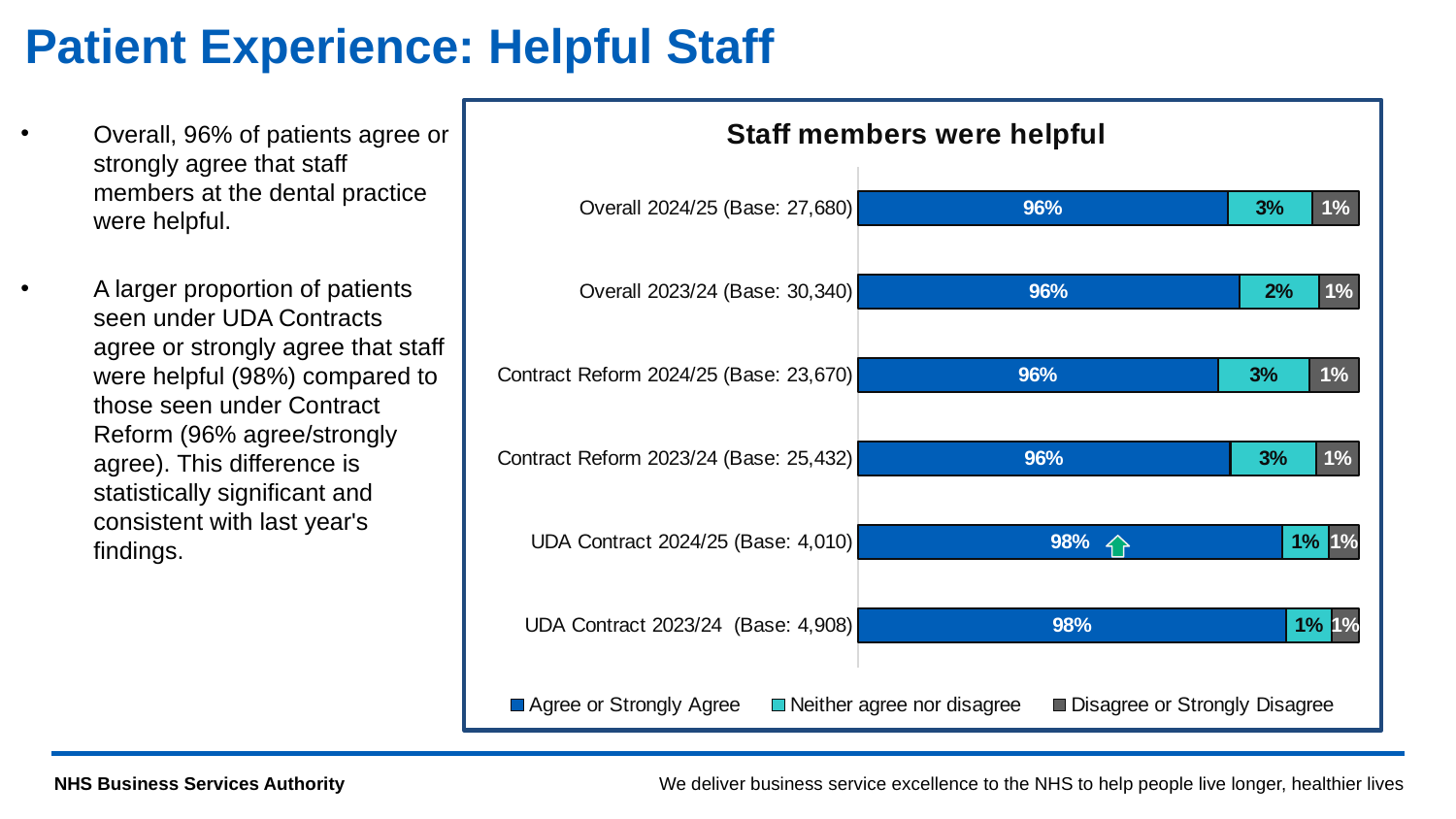
Which category has the highest 'Neither agree nor disagree' value? Overall 2024/25, Contract Reform 2024/25 and Contract Reform 2023/24 (all 3%) What is the 'Agree or Strongly Agree' value for UDA Contract 2024/25? 98% What type of chart is shown? Stacked bar chart What is the 'Disagree or Strongly Disagree' value for Contract Reform 2024/25? 1% How many series does the legend list? 3 What percentage of patients in the Overall 2024/25 group agree or strongly agree that staff members were helpful? 96% How many categories (bars) are shown in the chart? 6 Which is larger: the 'Neither agree nor disagree' value for Overall 2024/25 or for Overall 2023/24? Overall 2024/25 What is the title of the chart? Staff members were helpful What is the difference in 'Agree or Strongly Agree' between UDA Contract 2024/25 and Contract Reform 2024/25? 2 percentage points What is the base (number of respondents) for UDA Contract 2023/24? 4,908 What is the 'Neither agree nor disagree' value for Overall 2023/24? 2%